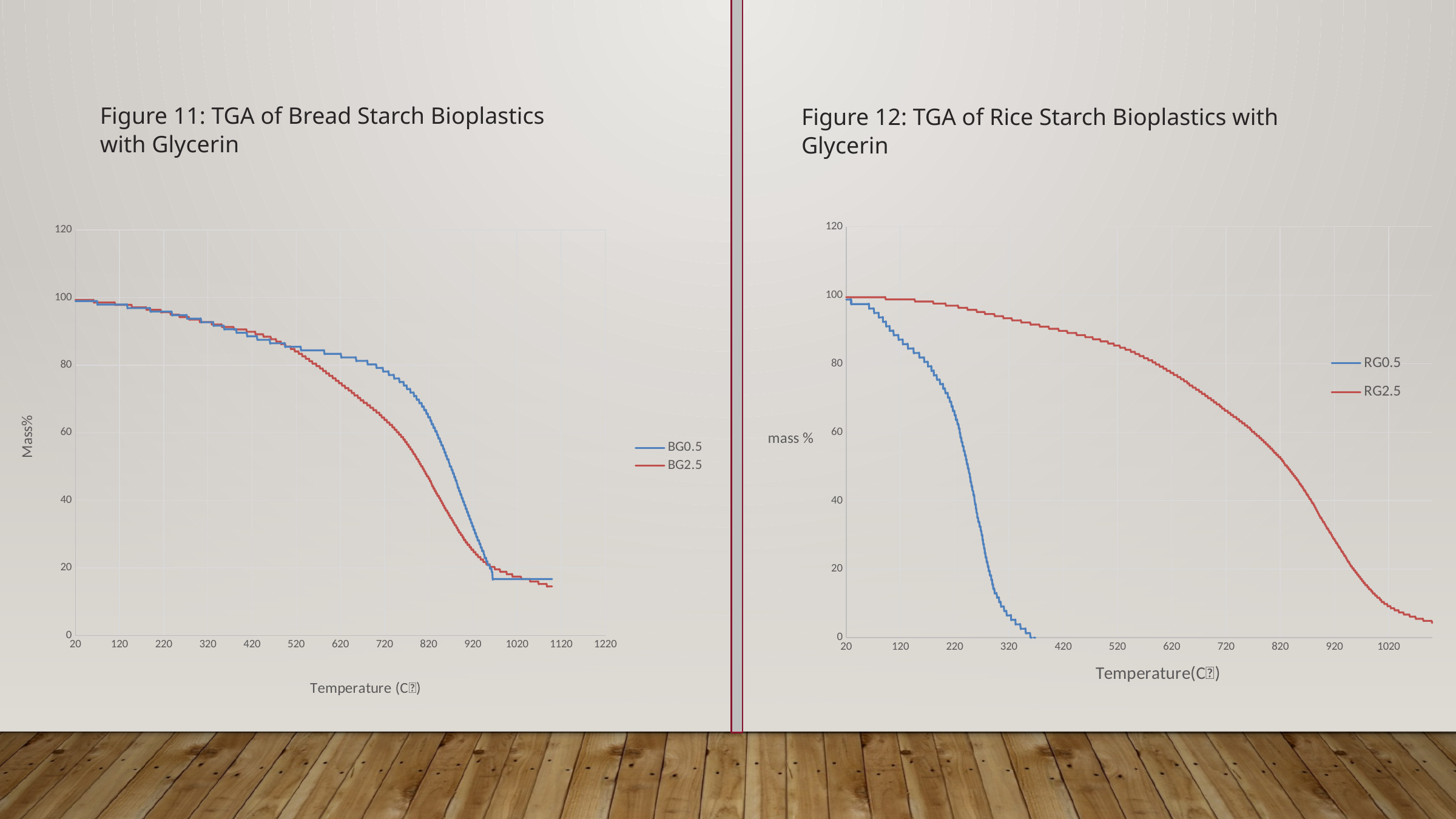
What kind of chart is Figure 11: TGA of Bread Starch Bioplastics with Glycerin? line chart In Figure 11, at a temperature of 820, which series has the higher Mass%, BG0.5 or BG2.5? BG0.5 How many series does the legend of Figure 12: TGA of Rice Starch Bioplastics with Glycerin list? 2 In Figure 12, at a temperature of 220, which series has the higher mass %, RG0.5 or RG2.5? RG2.5 In Figure 11, is the value for BG0.5 at 820 greater or less than 60? greater In Figure 11, what are the two series named in the legend? BG0.5 and BG2.5 In Figure 11, is the value for BG2.5 at 720 greater or less than 80? less In Figure 12, what is the label on the x axis? Temperature(C) In Figure 12, is the value for RG2.5 at 820 greater or less than 40? greater In Figure 11, do the Mass% values rise or fall as temperature increases along the x axis? fall In Figure 12, does the RG0.5 series rise or fall as temperature increases? fall